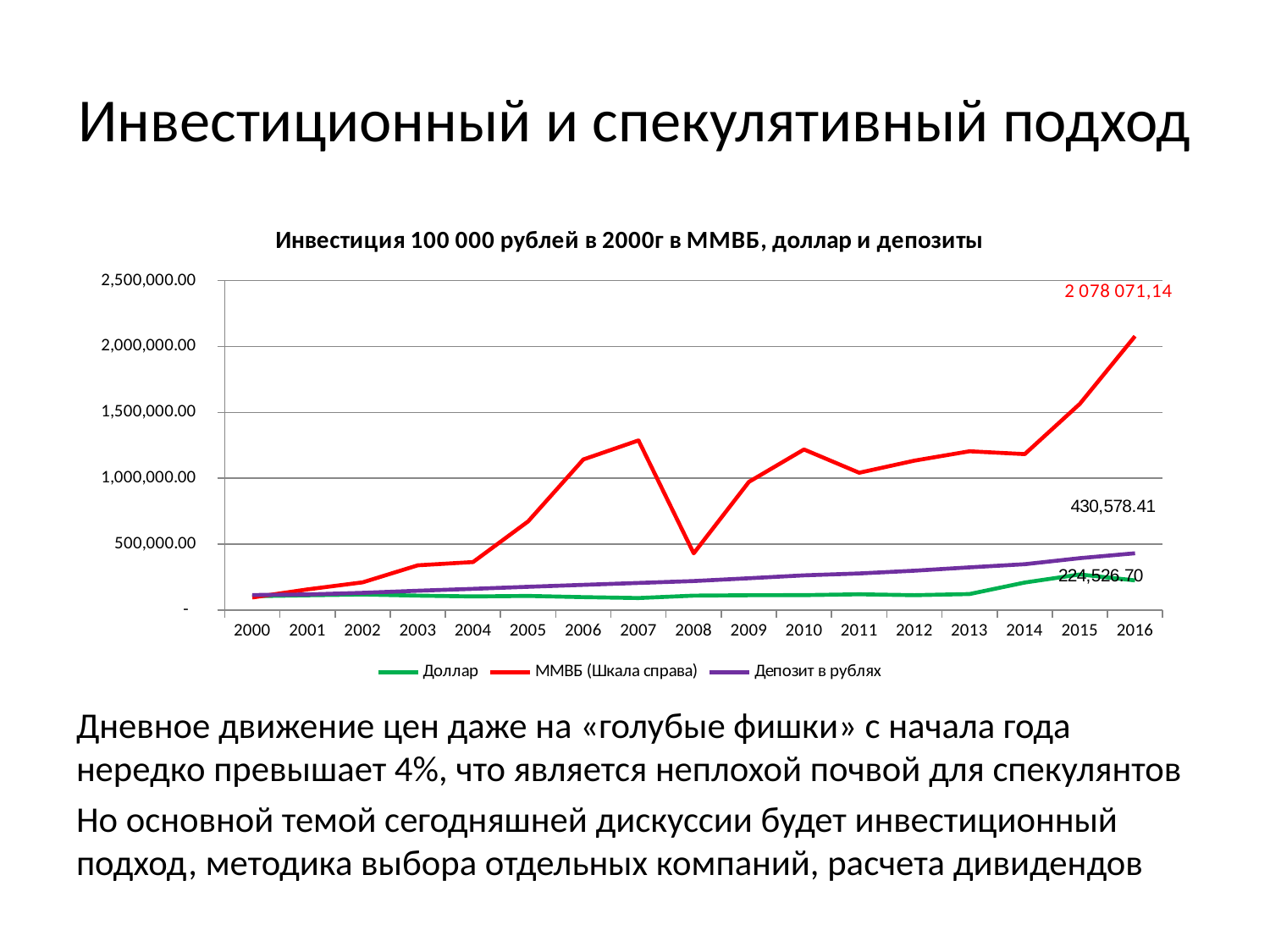
What kind of chart is shown on the slide? line chart In 2016, which is larger: Депозит в рублях or Доллар? Депозит в рублях Does the Депозит в рублях series rise or fall from 2000 to 2016? rise How many years are plotted along the x axis? 17 What is the labelled value of the Депозит в рублях series in 2016? 430,578.41 What is the labelled value of the ММВБ (Шкала справа) series in 2016? 2 078 071,14 How many series does the legend list? 3 Which series has the lowest value in 2016? Доллар What is the labelled value of the Доллар series in 2016? 224,526.70 Which series has the highest value in 2016? ММВБ (Шкала справа) What is the difference between the 2016 values of Депозит в рублях and Доллар? 206,051.71 What is the title of the chart? Инвестиция 100 000 рублей в 2000г в ММВБ, доллар и депозиты